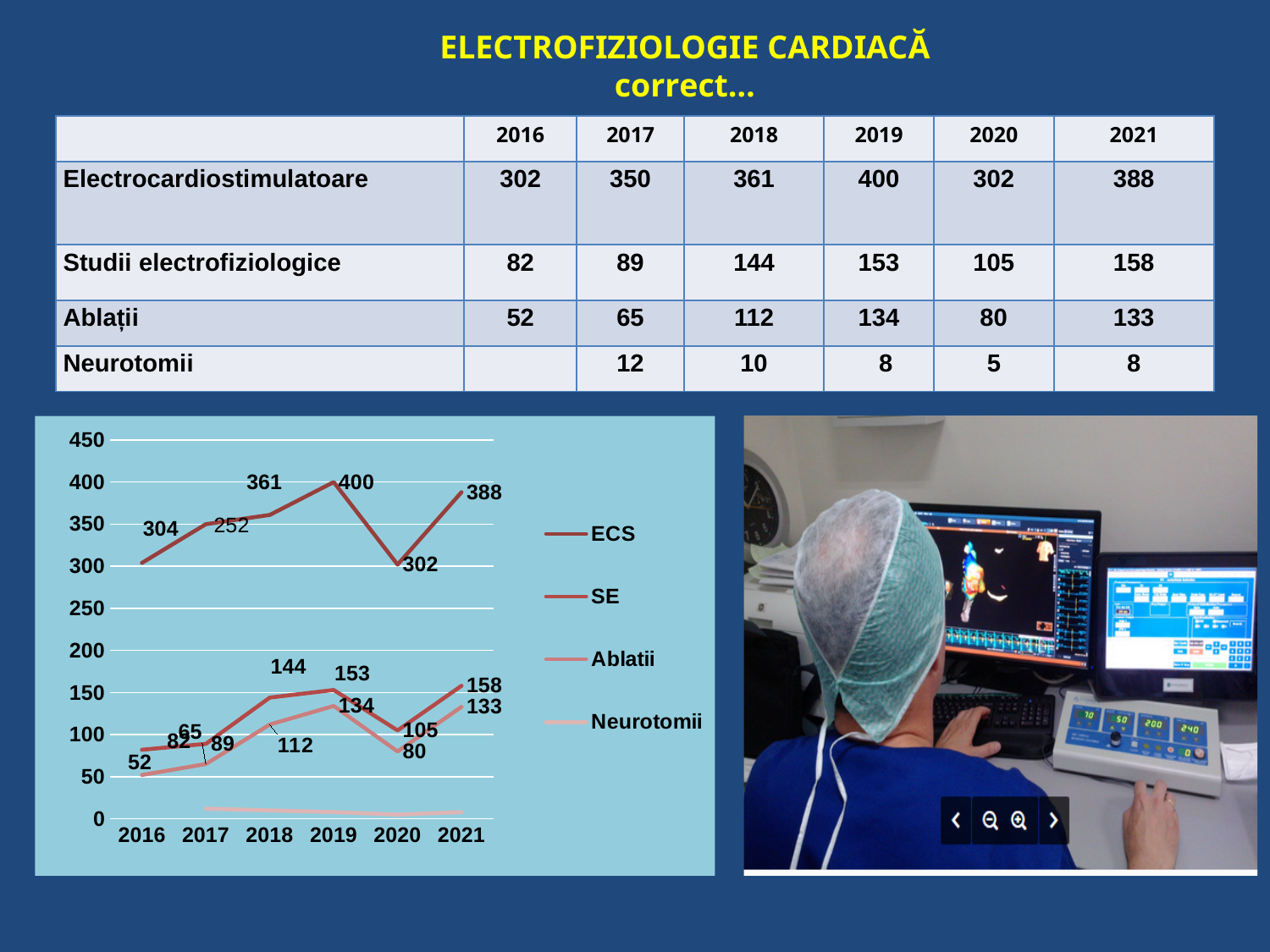
According to the chart, what is the SE value for 2018? 144 How many years are plotted along the x axis of the chart? 6 How many series does the chart's legend list? 4 What kind of chart is shown on the slide? line chart In which year is the Ablatii series lowest on the chart? 2016 According to the chart, what is the Ablatii value for 2020? 80 Is the Neurotomii value for 2017 on the chart greater or less than 50? less On the chart, which is larger in 2019: the SE value or the Ablatii value? SE Does the ECS series rise or fall from 2019 to 2020 on the chart? fall According to the chart, what is the ECS value for 2019? 400 On the chart, what is the difference between the SE values for 2021 and 2020? 53 In which year does the ECS series reach its highest value on the chart? 2019